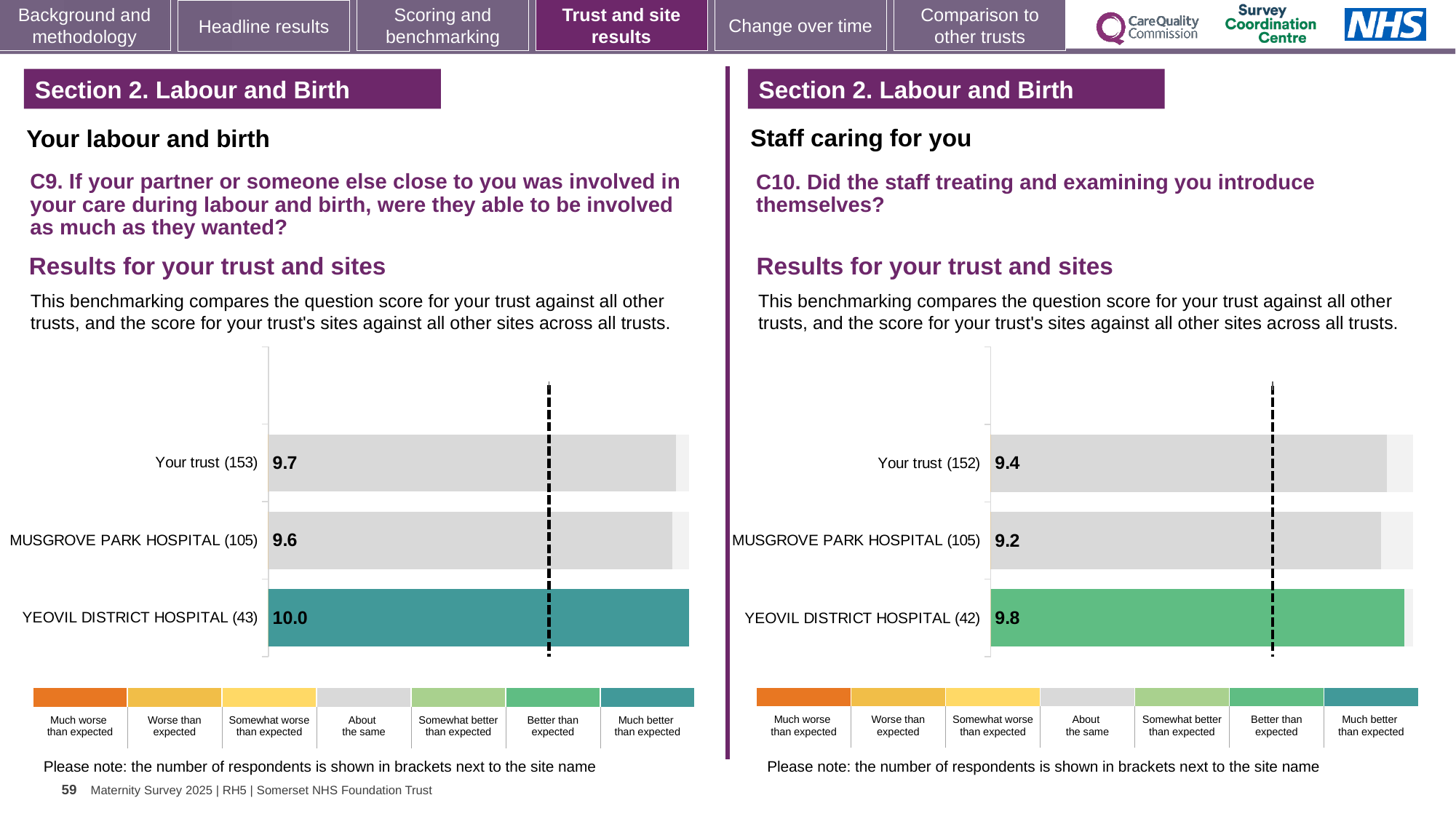
What type of chart is used on the left (C9)? Bar chart On the right chart (C10), what is the difference between the scores for YEOVIL DISTRICT HOSPITAL and MUSGROVE PARK HOSPITAL? 0.6 On the right chart (C10), what is the score for MUSGROVE PARK HOSPITAL? 9.2 On the left chart (C9), which site or trust has the highest score? YEOVIL DISTRICT HOSPITAL On the right chart (C10), how many respondents are shown in brackets for YEOVIL DISTRICT HOSPITAL? 42 On the right chart (C10), which site or trust has the lowest score? MUSGROVE PARK HOSPITAL On the left chart (C9), what is the score for YEOVIL DISTRICT HOSPITAL? 10.0 On the left chart (C9), which has the higher score, Your trust or MUSGROVE PARK HOSPITAL? Your trust On the right chart (C10), what is the score for Your trust? 9.4 How many bars are shown on the right chart (C10)? 3 On the left chart (C9), what is the score for Your trust? 9.7 On the left chart (C9), what is the difference between the scores for YEOVIL DISTRICT HOSPITAL and Your trust? 0.3